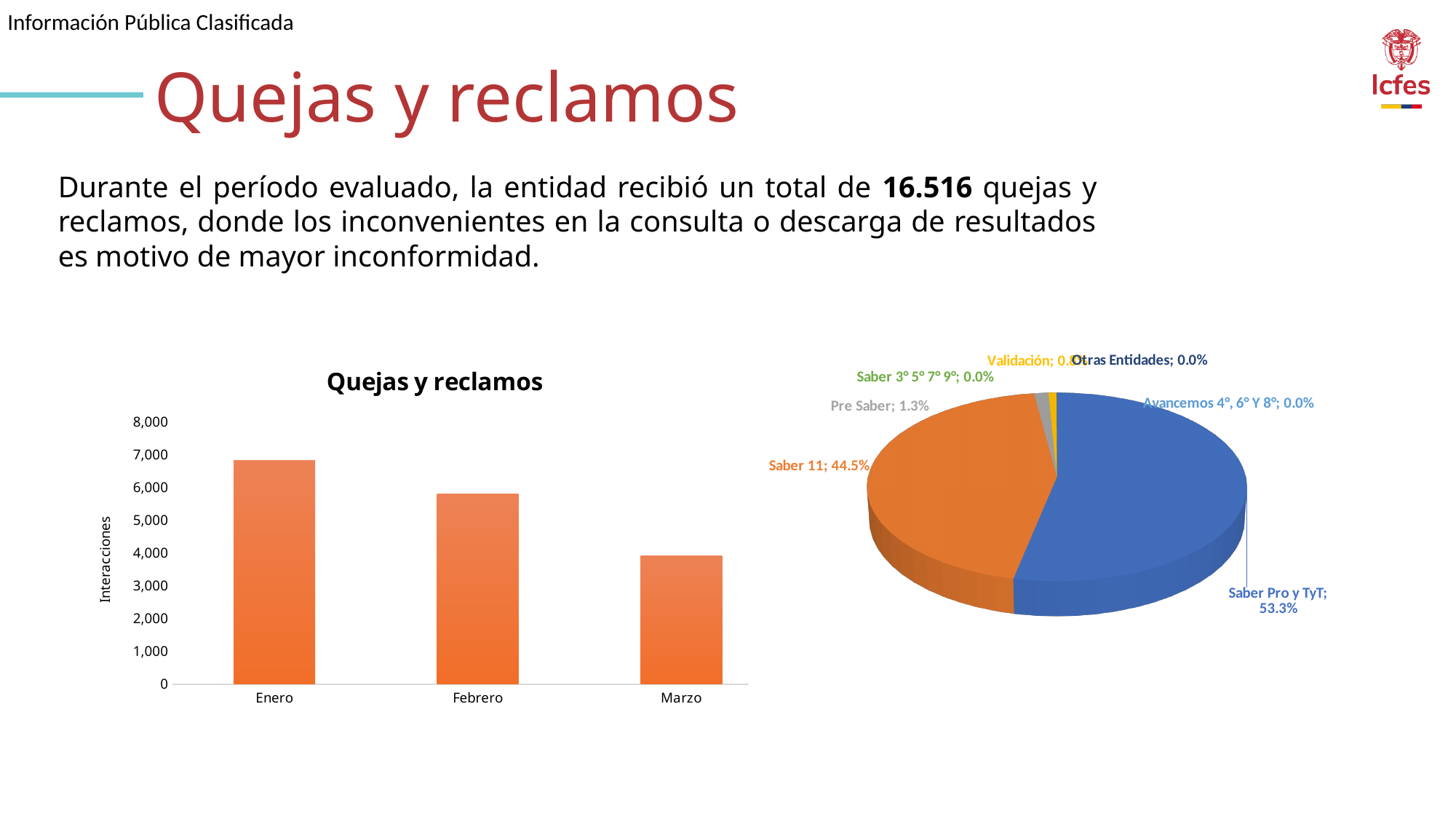
In the bar chart titled "Quejas y reclamos", how many months are shown on the x axis? 3 In the bar chart titled "Quejas y reclamos", which month has the highest value? Enero In the pie chart on the right of the slide, what share does Saber 11 have? 44.5% In the bar chart titled "Quejas y reclamos", is the value for Enero greater or less than 6,000? greater In the bar chart titled "Quejas y reclamos", is the value for Marzo greater or less than 5,000? less In the bar chart titled "Quejas y reclamos", what is the label on the vertical axis? Interacciones In the bar chart titled "Quejas y reclamos", which month has the lowest value? Marzo In the pie chart on the right of the slide, what share does Saber Pro y TyT have? 53.3% In the bar chart titled "Quejas y reclamos", do the values rise or fall from Enero to Marzo? Fall In the pie chart on the right of the slide, what is the difference in percentage points between the Saber Pro y TyT share and the Saber 11 share? 8.8 percentage points What kind of chart is the chart titled "Quejas y reclamos" on the left of the slide? Bar chart In the bar chart titled "Quejas y reclamos", which is larger, the value for Enero or the value for Febrero? Enero